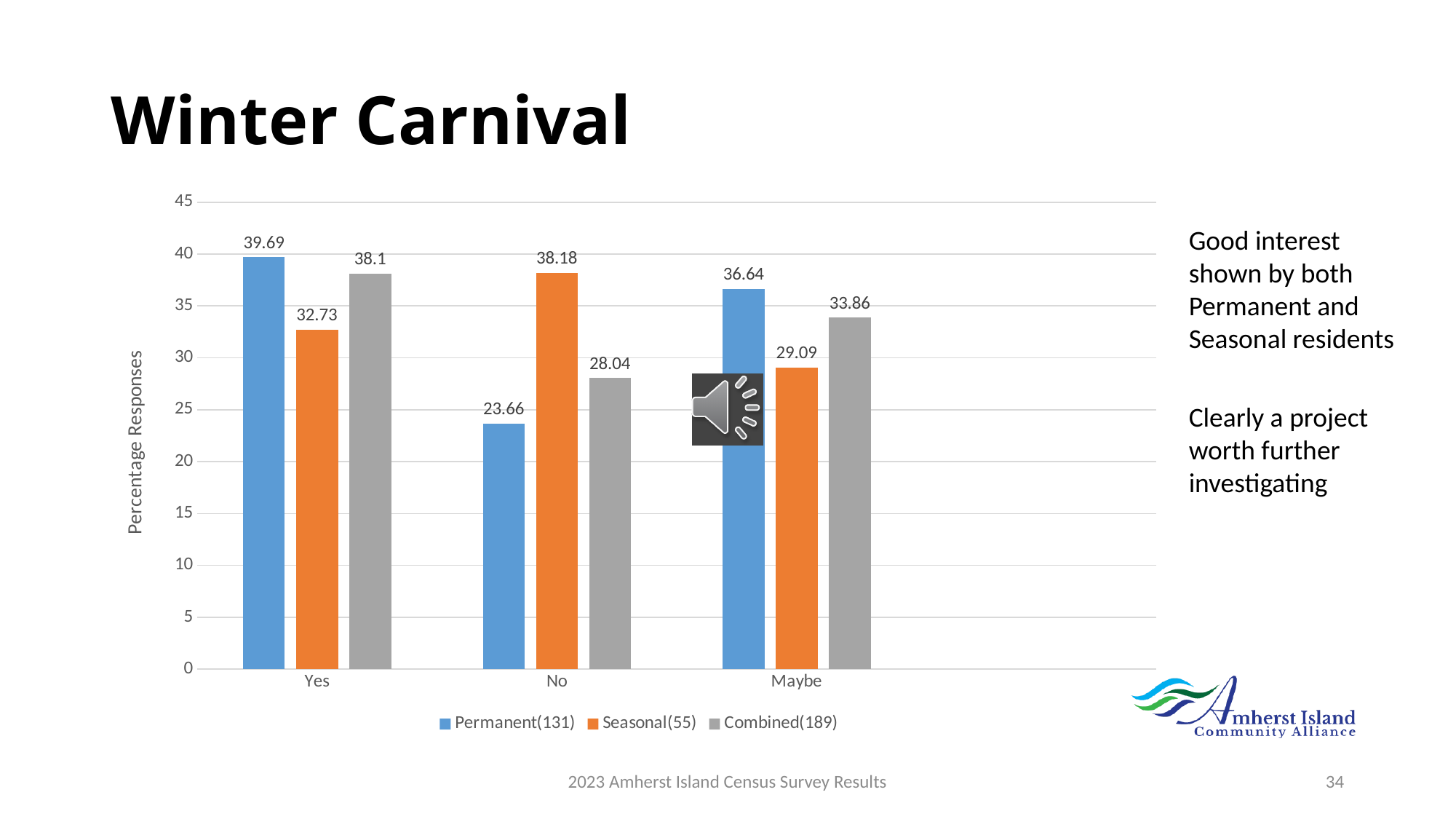
What is the value for Seasonal(55) in the No category? 38.18 What is the difference between the Permanent(131) and Seasonal(55) values in the No category? 14.52 How many categories are shown on the x axis? 3 Which is larger in the Maybe category: Permanent(131) or Seasonal(55)? Permanent(131) What is the value for Permanent(131) in the Yes category? 39.69 What is the value for Combined(189) in the Maybe category? 33.86 Which category has the highest value for Seasonal(55)? No Which category has the lowest value for Permanent(131)? No What kind of chart is shown on the slide? Bar chart How many series does the legend list? 3 Is the value for Combined(189) in the No category greater or less than 30? less What is the label of the y axis? Percentage Responses